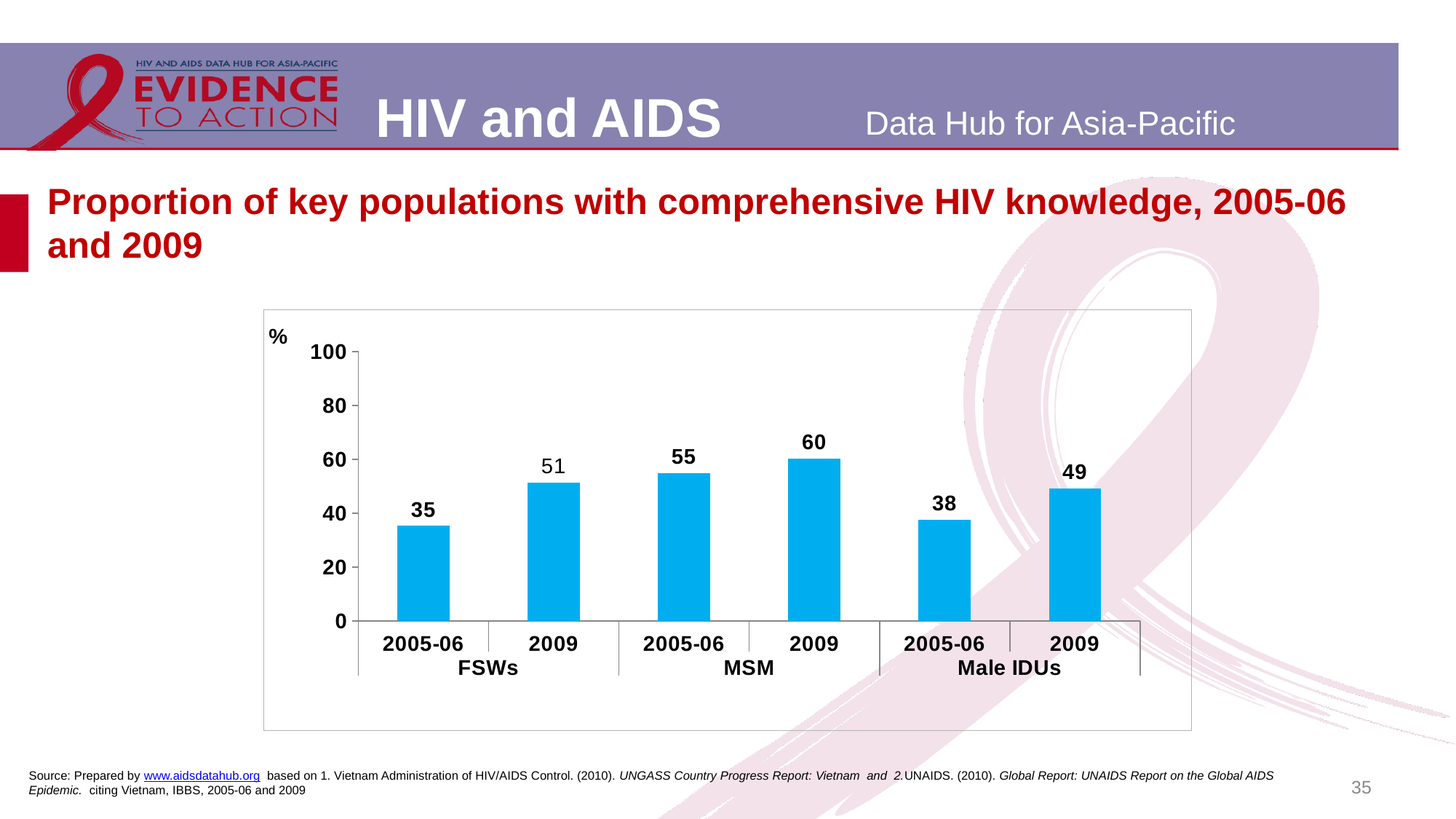
What is the value for MSM in 2009? 60 Which is larger, the 2009 value for FSWs or the 2009 value for Male IDUs? FSWs Is the value for MSM in 2005-06 greater or less than 40? greater Which bar has the highest value? MSM 2009 What kind of chart is shown on the slide? bar chart Which bar has the lowest value? FSWs 2005-06 What is the value for FSWs in 2005-06? 35 How many bars are plotted in the chart? 6 What is the value for Male IDUs in 2005-06? 38 What is the difference between the FSWs values for 2009 and 2005-06? 16 What unit is shown on the vertical axis of the chart? % What is the difference between the Male IDUs values for 2009 and 2005-06? 11